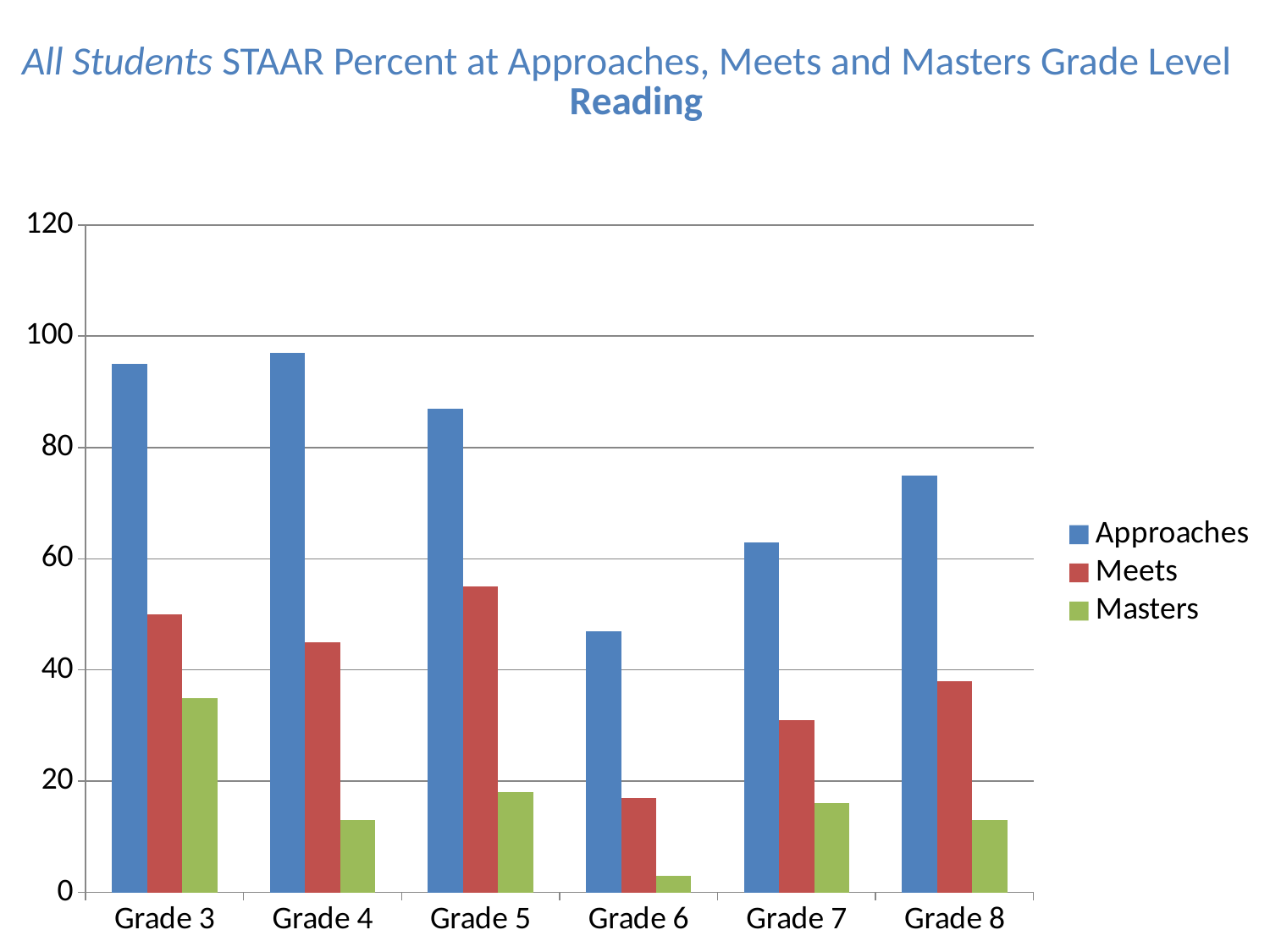
Which grade has the lowest Approaches value? Grade 6 Is the Approaches value for Grade 6 greater or less than 60? less Which grade has the highest Masters value? Grade 3 How many series does the legend list? 3 How many grade levels are shown along the x axis? 6 Which is larger, the Approaches value for Grade 7 or for Grade 8? Grade 8 Which grade has the lowest Meets value? Grade 6 Is the Masters value for Grade 6 greater or less than 20? less Is the Approaches value for Grade 5 greater or less than 80? greater What kind of chart is shown on the slide? bar chart Do the Approaches values rise or fall from Grade 3 to Grade 6? fall Which subject is named in the chart title? Reading